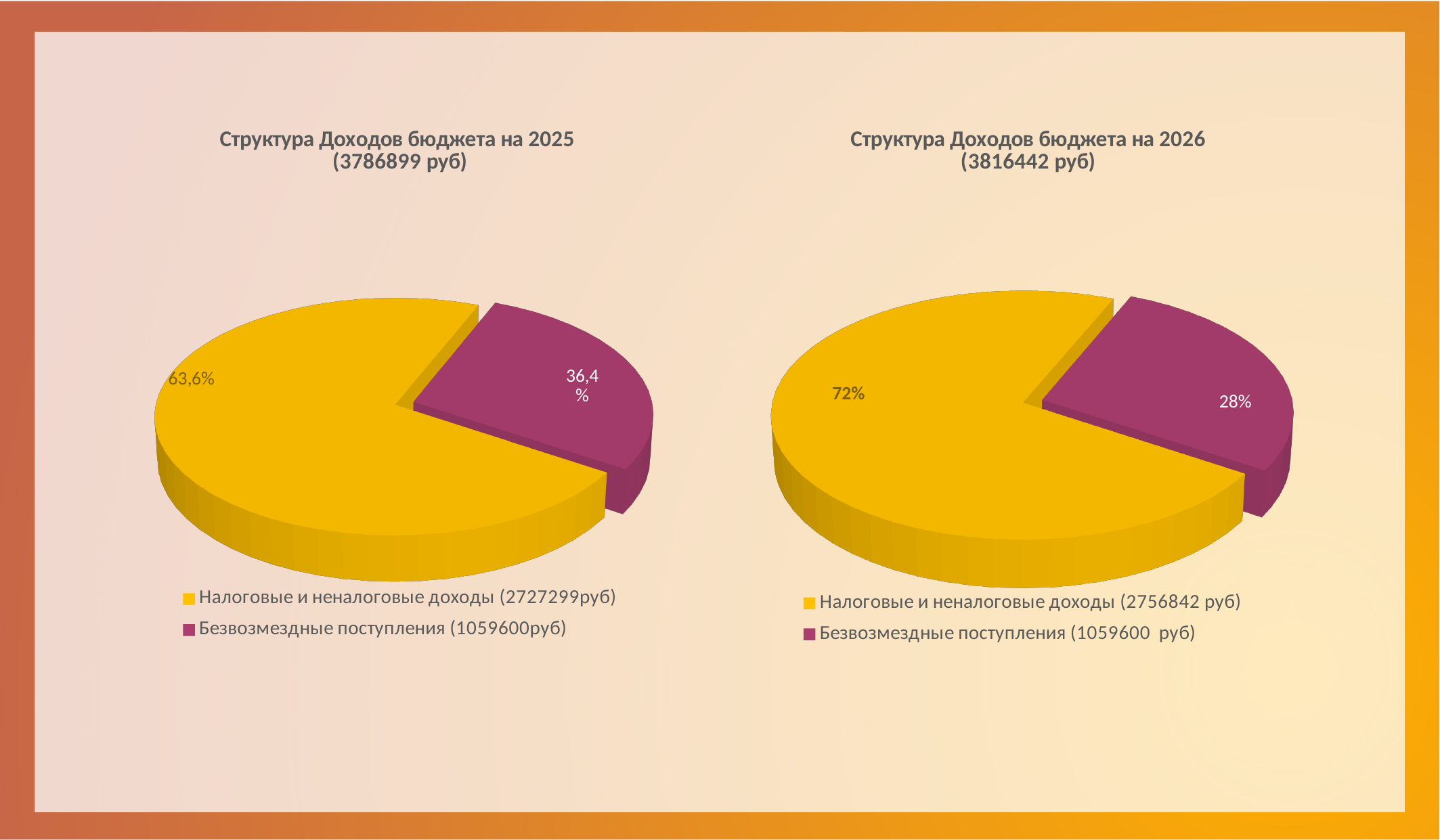
In the chart "Структура Доходов бюджета на 2025", what share of the pie is "Налоговые и неналоговые доходы"? 63,6% In the chart "Структура Доходов бюджета на 2026", what is the difference in percentage points between the two slices? 44 In the chart "Структура Доходов бюджета на 2025", what share of the pie is "Безвозмездные поступления"? 36,4% In the chart "Структура Доходов бюджета на 2026", which slice is the smallest? Безвозмездные поступления What kind of chart is used for "Структура Доходов бюджета на 2025"? pie chart Which is larger: the "Безвозмездные поступления" share in the 2025 chart or in the 2026 chart? 2025 How many slices does the chart "Структура Доходов бюджета на 2025" have? 2 In the chart "Структура Доходов бюджета на 2025", which slice is the largest? Налоговые и неналоговые доходы In the chart "Структура Доходов бюджета на 2025", what colour is the "Безвозмездные поступления" slice? purple In the chart "Структура Доходов бюджета на 2026", what share of the pie is "Налоговые и неналоговые доходы"? 72% What total amount is shown in the title of the chart "Структура Доходов бюджета на 2026"? 3816442 руб